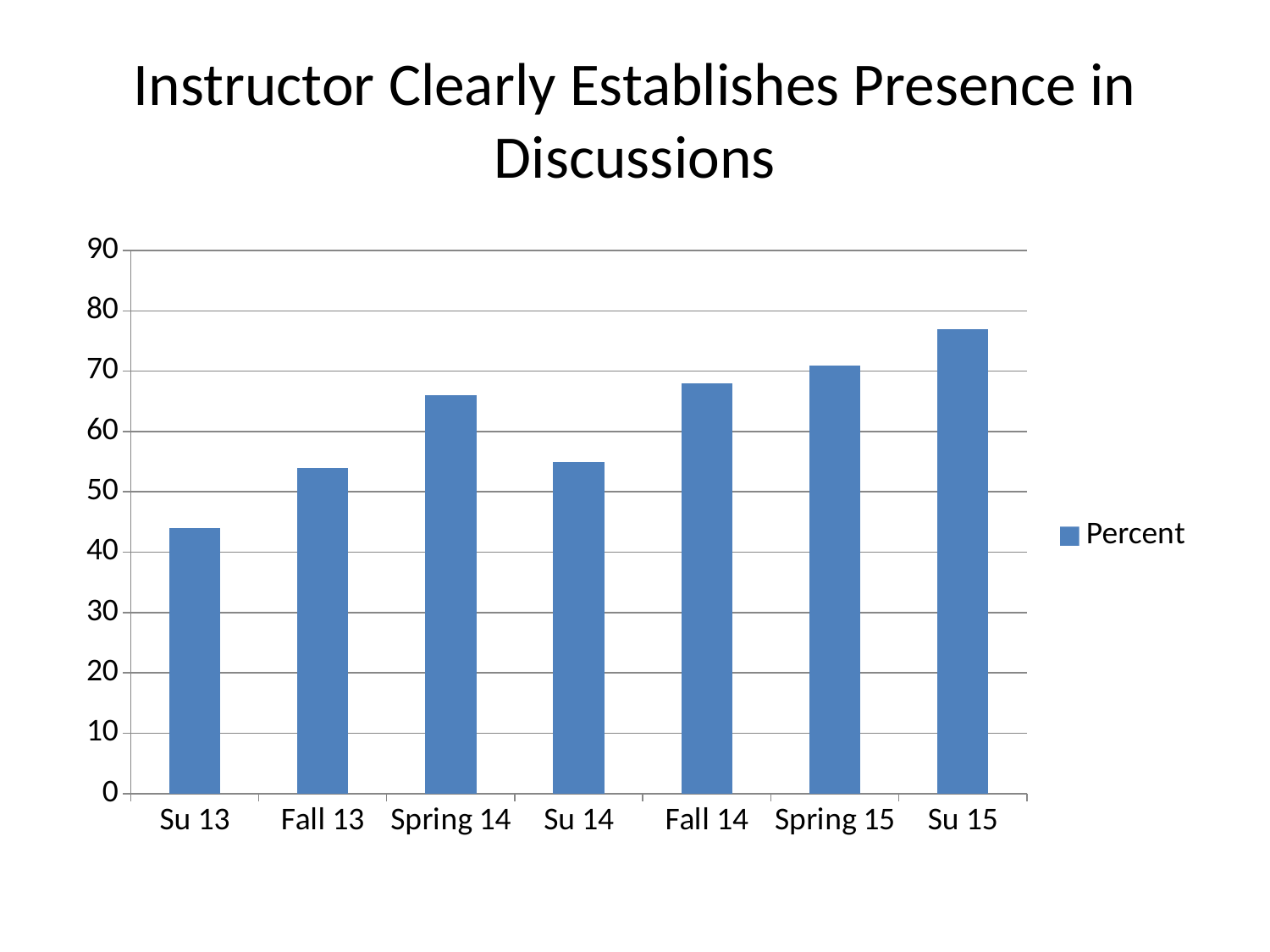
Which category has the highest value? Su 15 How many series does the legend list? 1 Is the value for Fall 14 greater or less than 60? greater Is the value for Su 15 greater or less than 70? greater How many categories are shown on the x axis of the chart? 7 Is the value for Spring 14 greater or less than 60? greater Which is larger, the value for Spring 15 or the value for Su 15? Su 15 What kind of chart is shown on the slide? Bar chart Which is larger, the value for Su 13 or the value for Fall 13? Fall 13 What is the name of the series shown in the legend? Percent Which category has the lowest value? Su 13